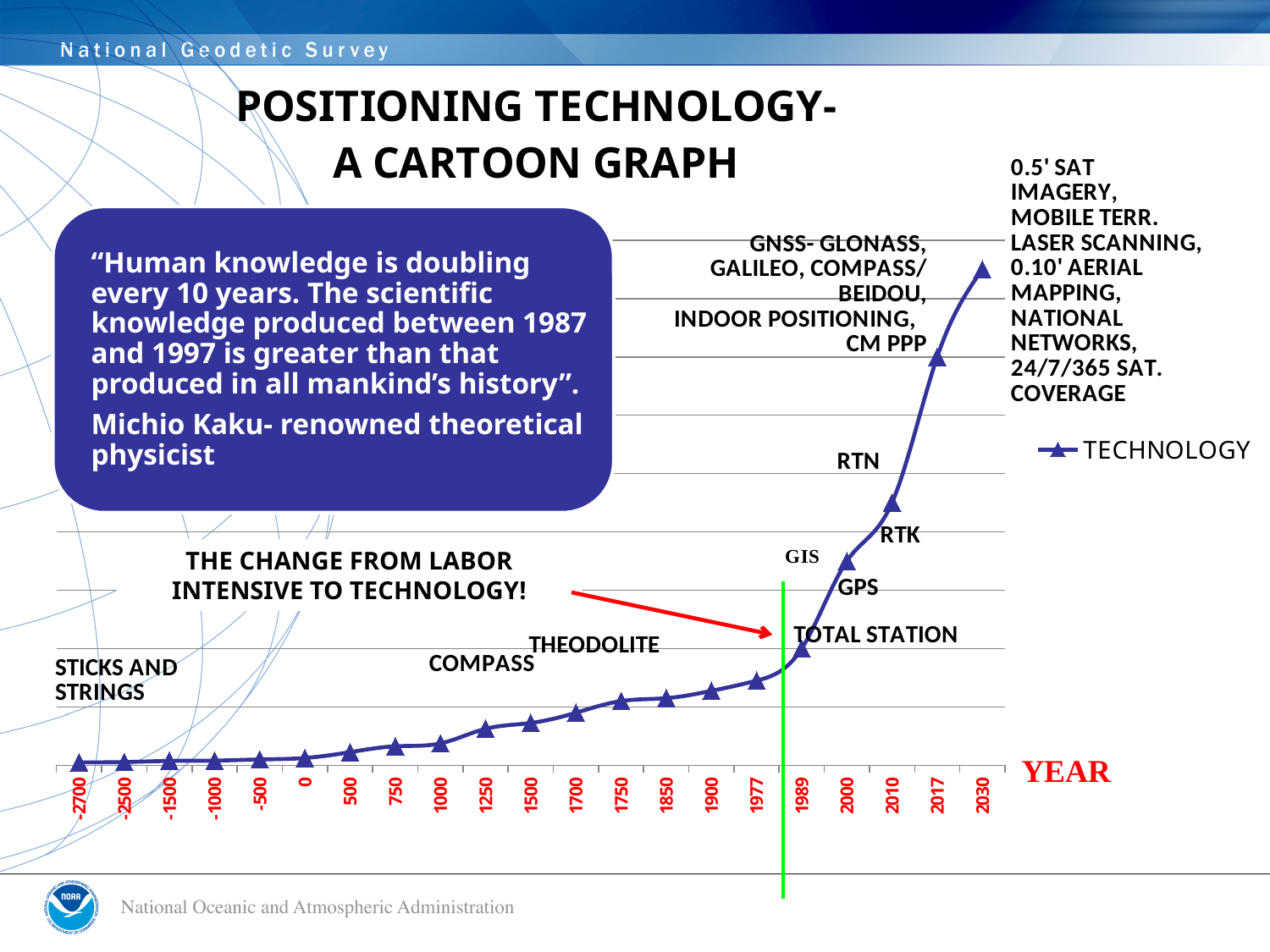
What is the last year shown on the x axis of the chart? 2030 Which has the larger value on the TECHNOLOGY line, 2010 or 1900? 2010 What kind of chart is shown on the slide? line chart What is the name of the series shown in the chart legend? TECHNOLOGY Which has the larger value on the TECHNOLOGY line, 1977 or 2030? 2030 What is the first year shown on the x axis of the chart? -2700 Which has the larger value on the TECHNOLOGY line, 500 or 1500? 1500 Which year has the highest value on the TECHNOLOGY line? 2030 How many year categories are shown along the x axis of the chart? 21 Do the values of the TECHNOLOGY line rise or fall as the years increase along the x axis? rise How many series does the chart legend list? 1 What is the label of the x axis of the chart? YEAR